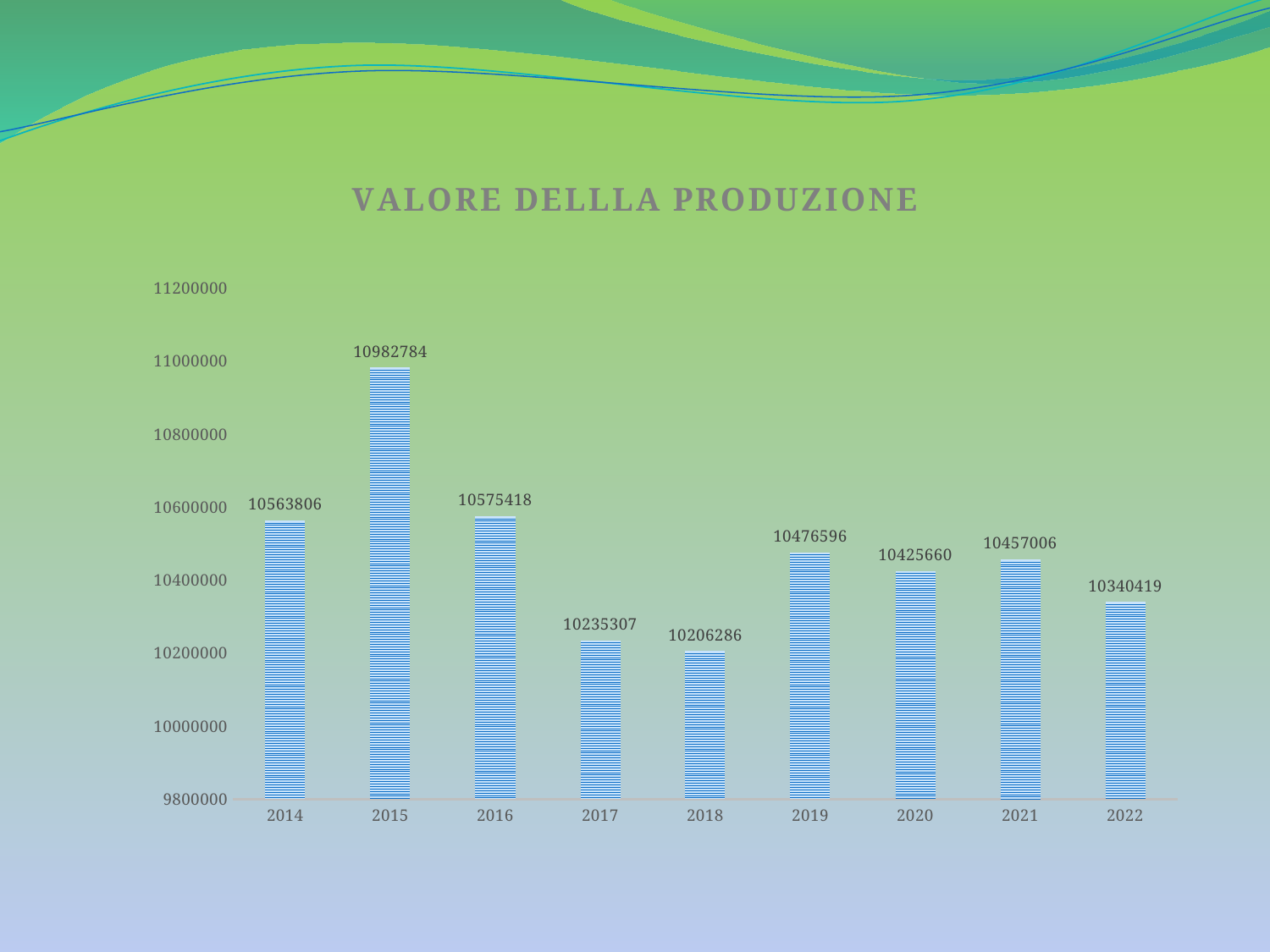
What is the value for 2015? 10982784 What is the difference between the values for 2021 and 2020? 31346 Is the value for 2022 greater or less than 10400000? less What is the difference between the values for 2015 and 2014? 418978 What is the value for 2022? 10340419 Which year has the lowest value? 2018 Do the values rise or fall from 2016 to 2018? fall Which year has the highest value? 2015 What kind of chart is this? bar chart What is the value for 2018? 10206286 Which is larger, the value for 2019 or the value for 2021? 2019 How many years are shown on the x axis? 9